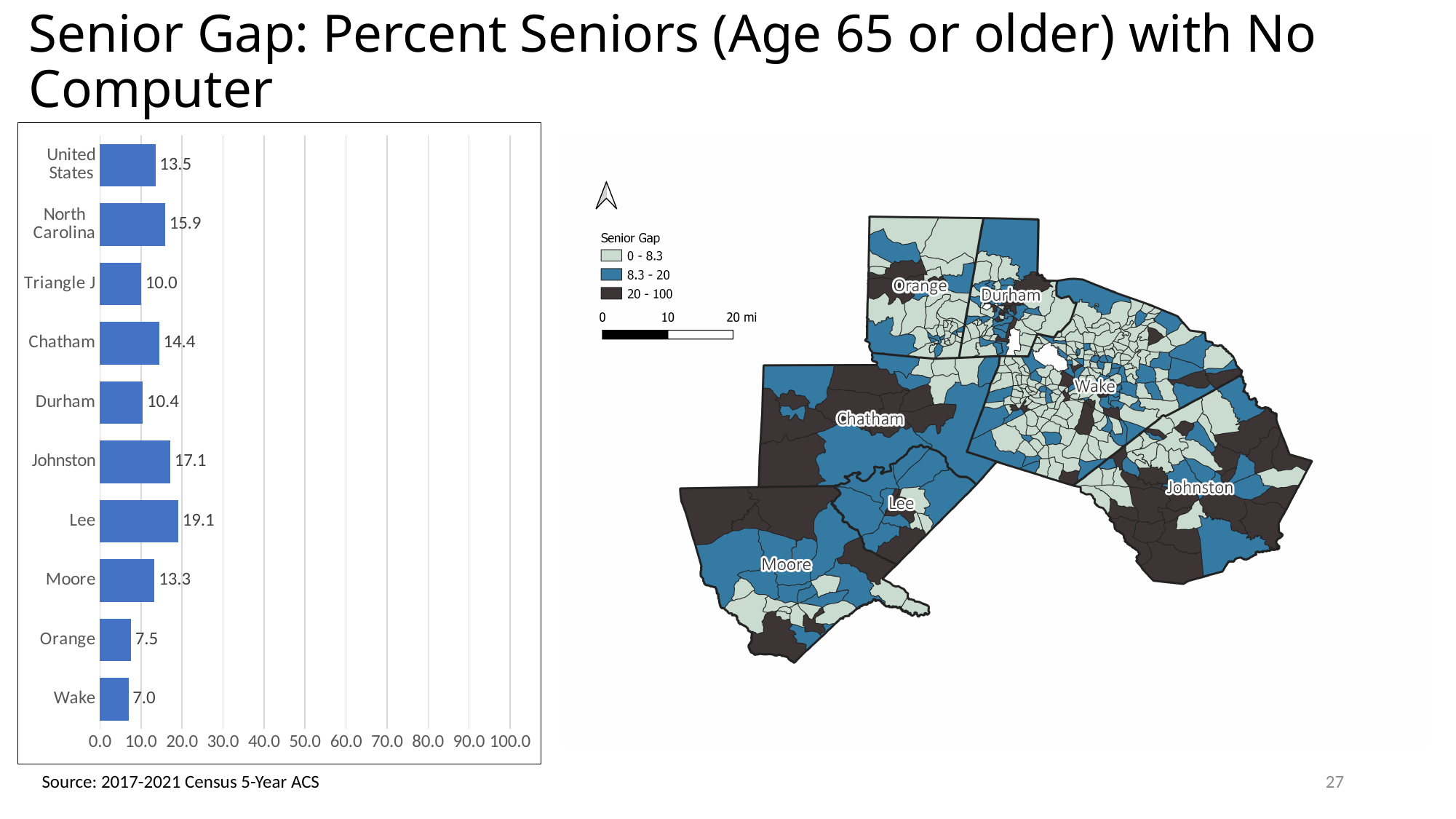
In the bar chart, what is the value for Lee? 19.1 How many Senior Gap classes does the map legend list? 3 In the bar chart, which is larger, the value for Chatham or the value for Moore? Chatham In the bar chart, what is the difference between the values for Lee and Wake? 12.1 In the bar chart, which category has the lowest value? Wake In the bar chart, is the value for Johnston greater or less than 20.0? less In the bar chart, what is the difference between the values for Johnston and Durham? 6.7 In the bar chart, what is the value for Triangle J? 10.0 What type of chart is shown on the left side of the slide? bar chart In the bar chart, what is the value for North Carolina? 15.9 In the bar chart, which category has the highest value? Lee How many categories are shown in the bar chart? 10